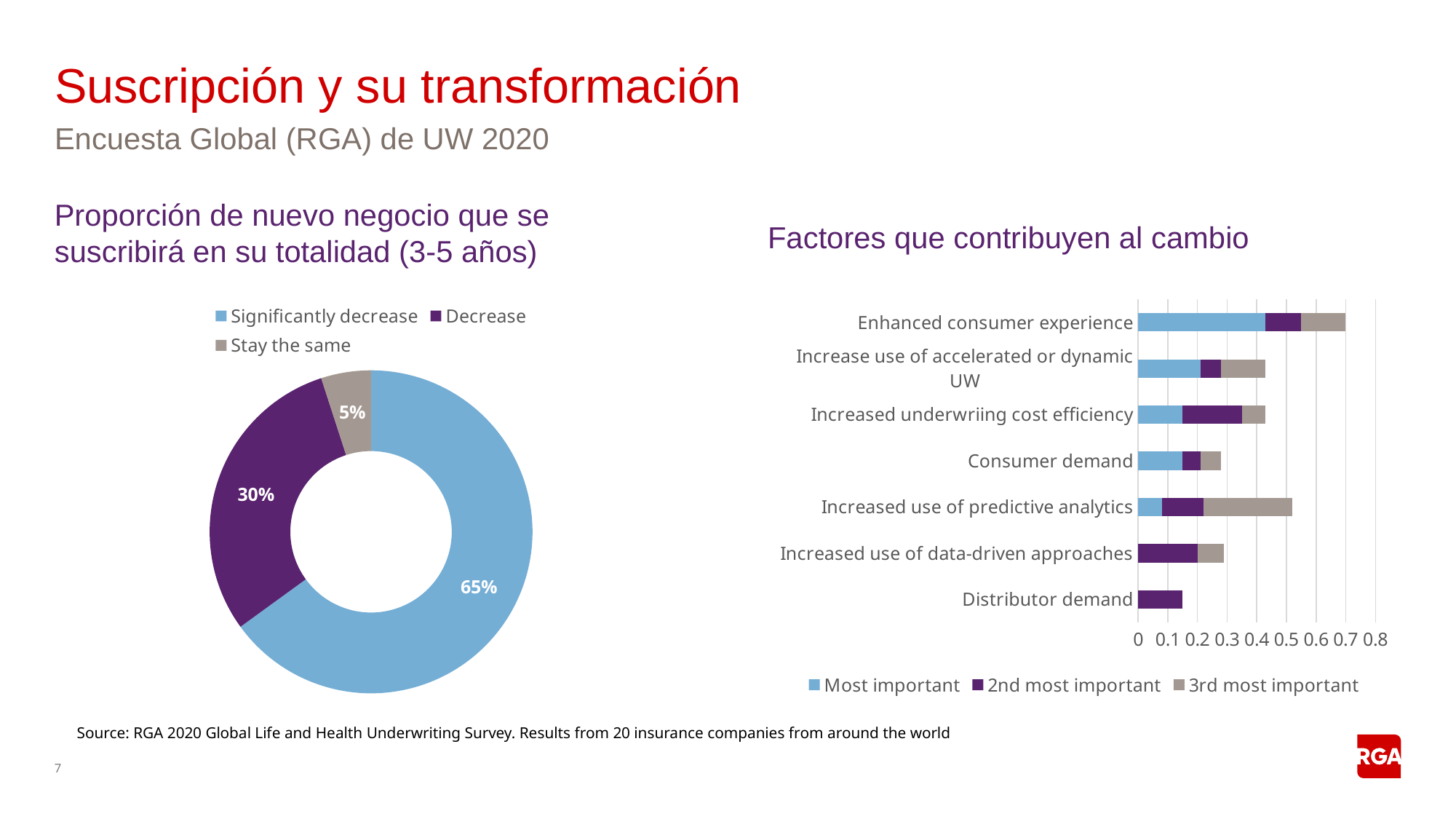
In the chart titled 'Proporción de nuevo negocio que se suscribirá en su totalidad (3-5 años)', what percentage is shown for 'Significantly decrease'? 65% In the chart titled 'Proporción de nuevo negocio que se suscribirá en su totalidad (3-5 años)', what percentage is shown for 'Stay the same'? 5% In the chart titled 'Factores que contribuyen al cambio', how many series does the legend list? 3 In the chart titled 'Factores que contribuyen al cambio', how many factors (categories) are plotted? 7 In the chart titled 'Factores que contribuyen al cambio', which factor has the shortest total bar? Distributor demand In the chart titled 'Proporción de nuevo negocio que se suscribirá en su totalidad (3-5 años)', what percentage is shown for 'Decrease'? 30% In the chart titled 'Proporción de nuevo negocio que se suscribirá en su totalidad (3-5 años)', which category has the largest share? Significantly decrease What kind of chart is the one titled 'Factores que contribuyen al cambio'? Stacked bar chart In the chart titled 'Factores que contribuyen al cambio', which factor has the longest total bar? Enhanced consumer experience In the chart titled 'Factores que contribuyen al cambio', is the total bar length for 'Distributor demand' greater or less than 0.2? less In the chart titled 'Proporción de nuevo negocio que se suscribirá en su totalidad (3-5 años)', what is the difference in percentage points between 'Significantly decrease' and 'Decrease'? 35 In the chart titled 'Proporción de nuevo negocio que se suscribirá en su totalidad (3-5 años)', how many categories does the legend list? 3